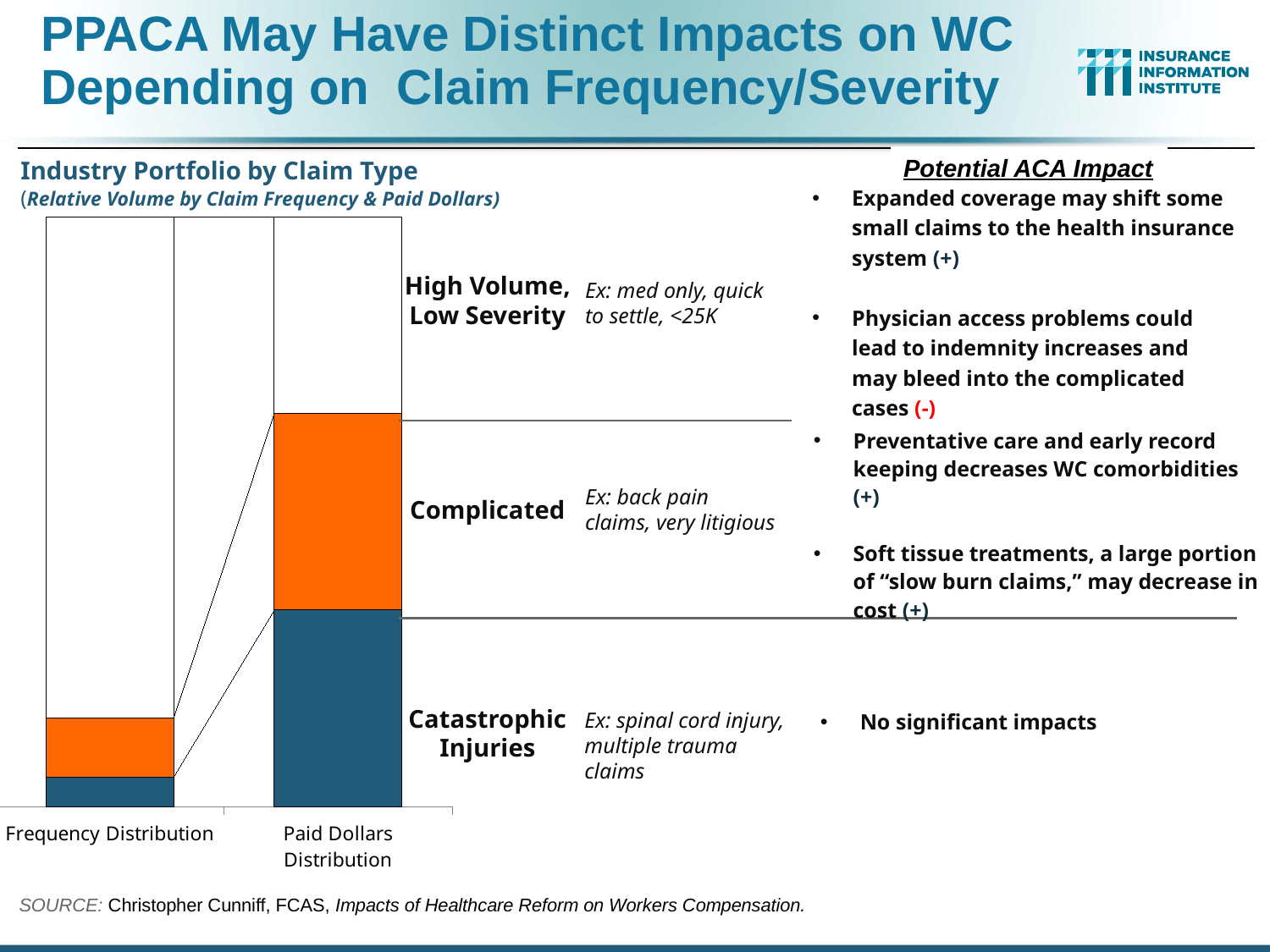
What is the title of the chart? Industry Portfolio by Claim Type How many categories are shown along the x axis of the chart? 2 Which claim type makes up the largest portion of the Frequency Distribution bar? High Volume, Low Severity Is the Complicated segment larger in the Frequency Distribution bar or the Paid Dollars Distribution bar? Paid Dollars Distribution Which claim type is shown in orange in the chart? Complicated Which claim type makes up the smallest portion of the Frequency Distribution bar? Catastrophic Injuries Is the High Volume, Low Severity segment larger in the Frequency Distribution bar or the Paid Dollars Distribution bar? Frequency Distribution Is the Catastrophic Injuries segment larger in the Frequency Distribution bar or the Paid Dollars Distribution bar? Paid Dollars Distribution What kind of chart is shown on the slide? Stacked bar chart How many claim types are stacked in each bar of the chart? 3 What are the two categories shown along the x axis of the chart? Frequency Distribution and Paid Dollars Distribution